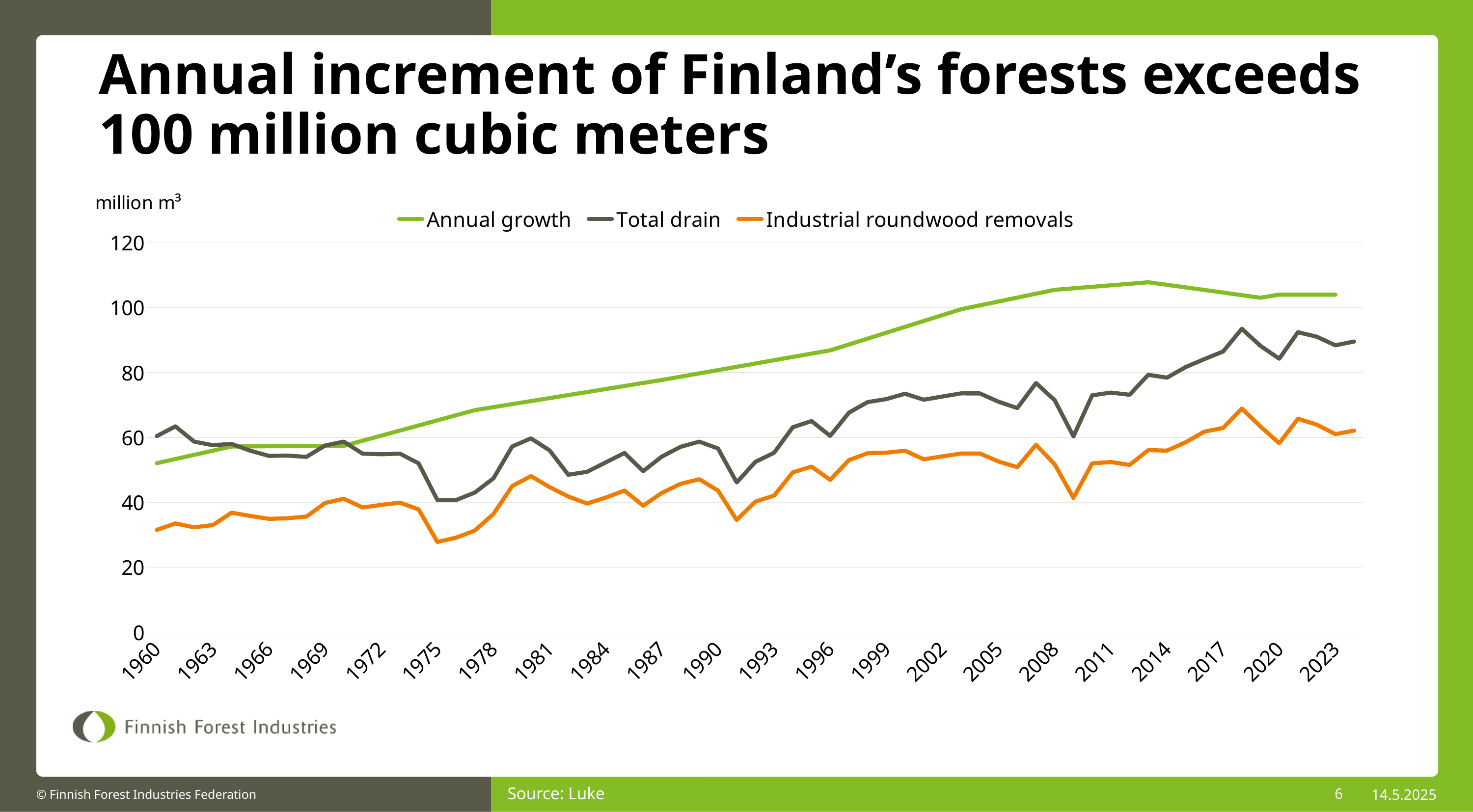
What unit is shown above the vertical axis? million m³ What kind of chart is shown on the slide? line chart In 1975, which is higher, Total drain or Industrial roundwood removals? Total drain Is the value for Annual growth in 1960 greater or less than 60? less In 2023, which is higher, Annual growth or Total drain? Annual growth Is the value for Industrial roundwood removals in 1975 greater or less than 40? less Is the value for Total drain in 1960 greater or less than 80? less What are the three series named in the legend? Annual growth, Total drain, Industrial roundwood removals Does the Annual growth line rise or fall from 1960 to 2023? rises How many series does the legend list? 3 Which series has the lowest values across the whole period? Industrial roundwood removals